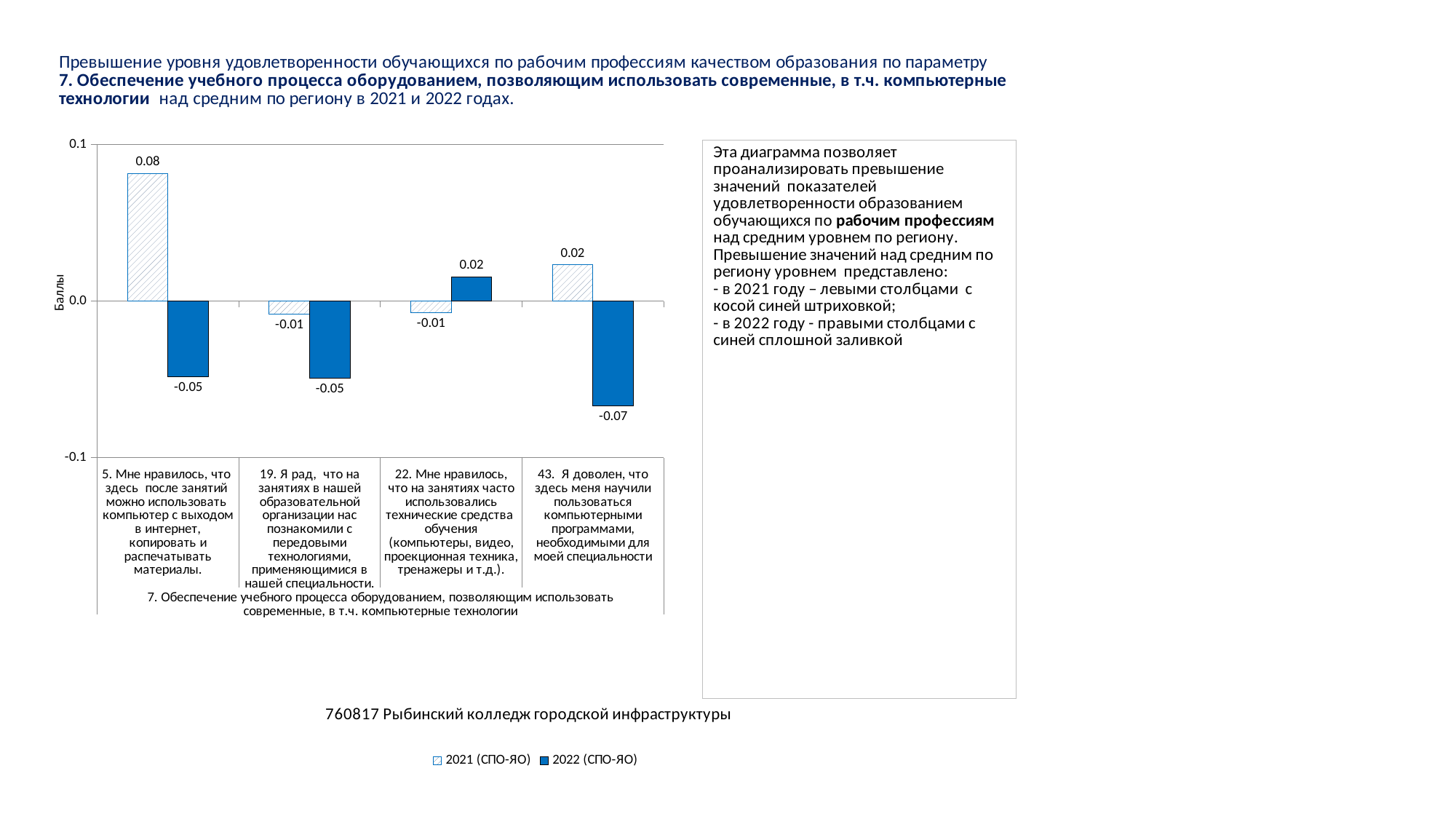
Which category has the highest value for the 2021 (СПО-ЯО) series? 5. Мне нравилось, что здесь после занятий можно использовать компьютер с выходом в интернет, копировать и распечатывать материалы. Which category has the lowest value for the 2022 (СПО-ЯО) series? 43. Я доволен, что здесь меня научили пользоваться компьютерными программами, необходимыми для моей специальности For category 22, which series has the larger value, 2021 (СПО-ЯО) or 2022 (СПО-ЯО)? 2022 (СПО-ЯО) What is the value for the 2021 (СПО-ЯО) series for category 5 ("Мне нравилось, что здесь после занятий можно использовать компьютер...")? 0.08 What kind of chart is shown on the slide? Bar chart How many series does the chart legend list? 2 How many categories are shown on the x axis of the chart? 4 What is the value for the 2022 (СПО-ЯО) series for category 22 ("Мне нравилось, что на занятиях часто использовались технические средства обучения...")? 0.02 What is the value for the 2021 (СПО-ЯО) series for category 19 ("Я рад, что на занятиях в нашей образовательной организации нас познакомили с передовыми технологиями...")? -0.01 What is the difference between the 2021 and 2022 values for category 5? 0.13 What is the label of the vertical axis of the chart? Баллы What is the value for the 2022 (СПО-ЯО) series for category 43 ("Я доволен, что здесь меня научили пользоваться компьютерными программами...")? -0.07